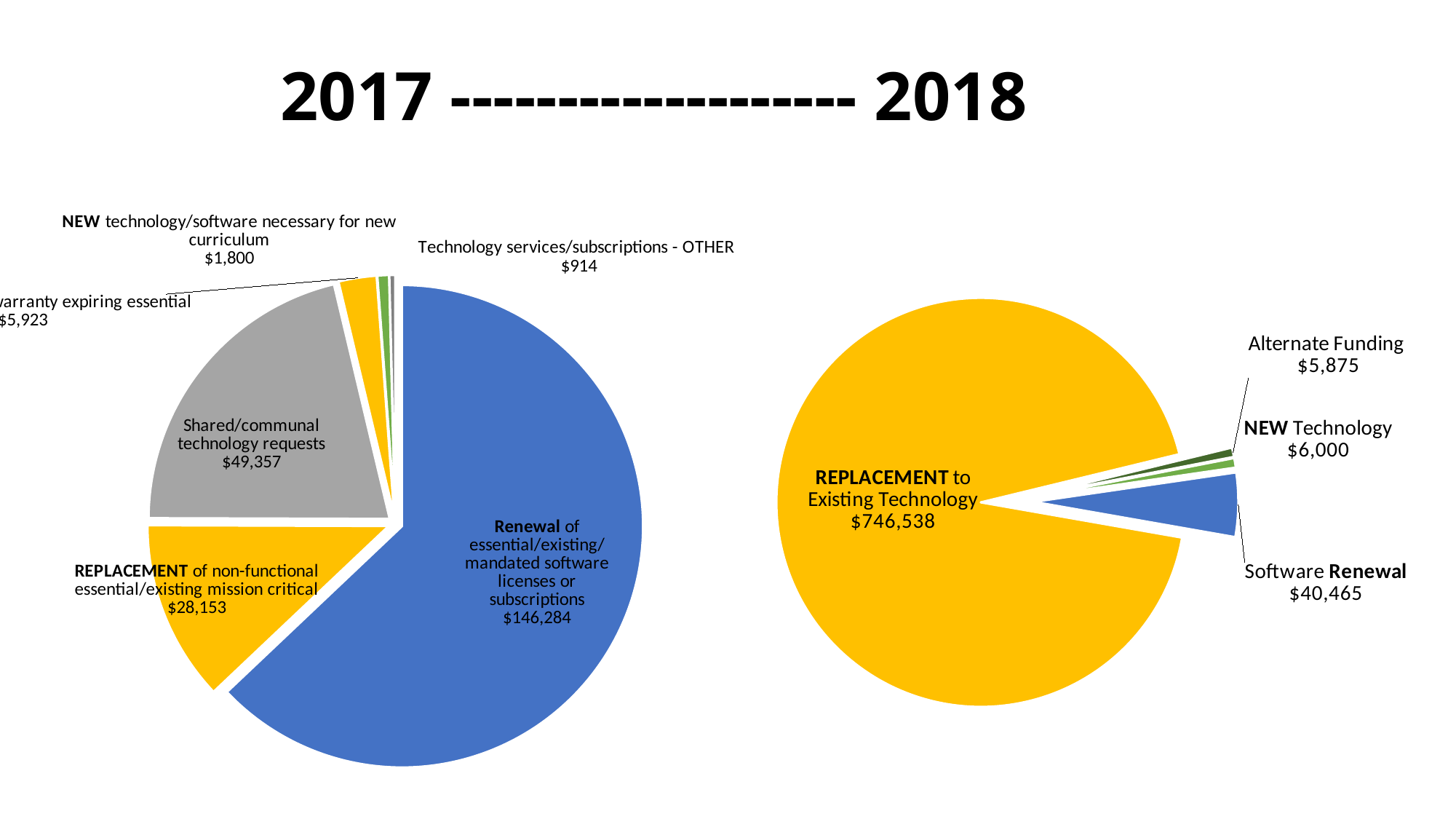
On the right (2018) pie chart, which is larger: NEW Technology or Alternate Funding? NEW Technology What type of chart is shown on the left side of the slide? Pie chart On the right (2018) pie chart, what is the value for Software Renewal? $40,465 On the left (2017) pie chart, which category has the smallest value? Technology services/subscriptions - OTHER On the right (2018) pie chart, what is the value for REPLACEMENT to Existing Technology? $746,538 On the left (2017) pie chart, which category has the largest slice? Renewal of essential/existing/mandated software licenses or subscriptions On the left (2017) pie chart, what is the value for Shared/communal technology requests? $49,357 On the left (2017) pie chart, what is the difference between the Renewal of software licenses value and the Shared/communal technology requests value? $96,927 How many slices does the right (2018) pie chart have? 4 On the left (2017) pie chart, what is the value for Renewal of essential/existing/mandated software licenses or subscriptions? $146,284 On the right (2018) pie chart, which category has the smallest value? Alternate Funding On the left (2017) pie chart, what is the value for Technology services/subscriptions - OTHER? $914